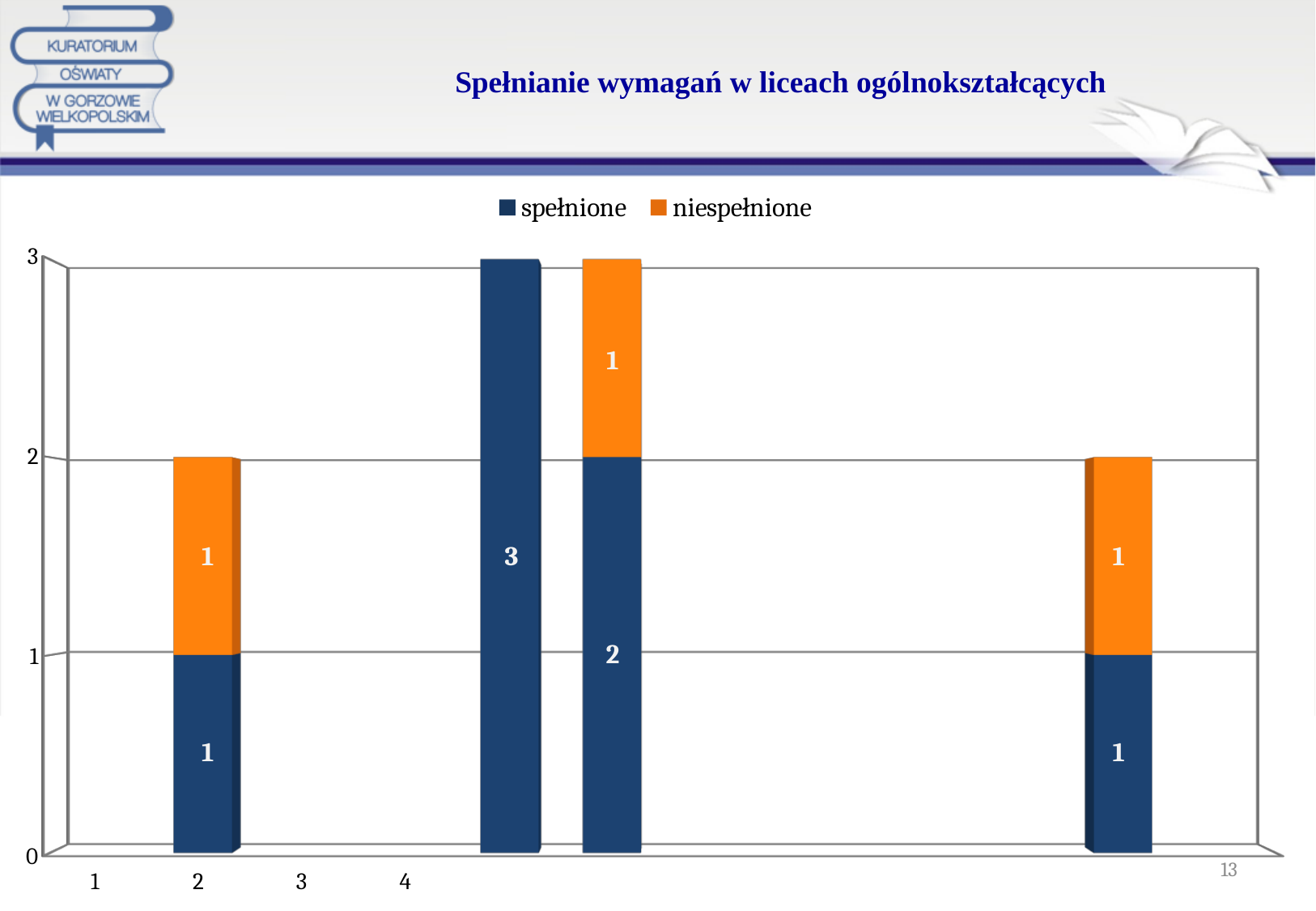
What is the total of the third stacked bar from the left? 3 What is the spełnione value for category 2? 1 What is the total of the stacked bar for category 2? 2 What kind of chart is shown on the slide? bar chart How many stacked bars are plotted in the chart? 4 What are the two series named in the legend? spełnione, niespełnione What is the title of the chart? Spełnianie wymagań w liceach ogólnokształcących Which bar has the highest spełnione value? the second bar from the left What is the niespełnione value of the third bar from the left? 1 What is the spełnione value of the second bar from the left (the all-dark-blue bar)? 3 How many series does the legend list? 2 What is the niespełnione value for category 2? 1